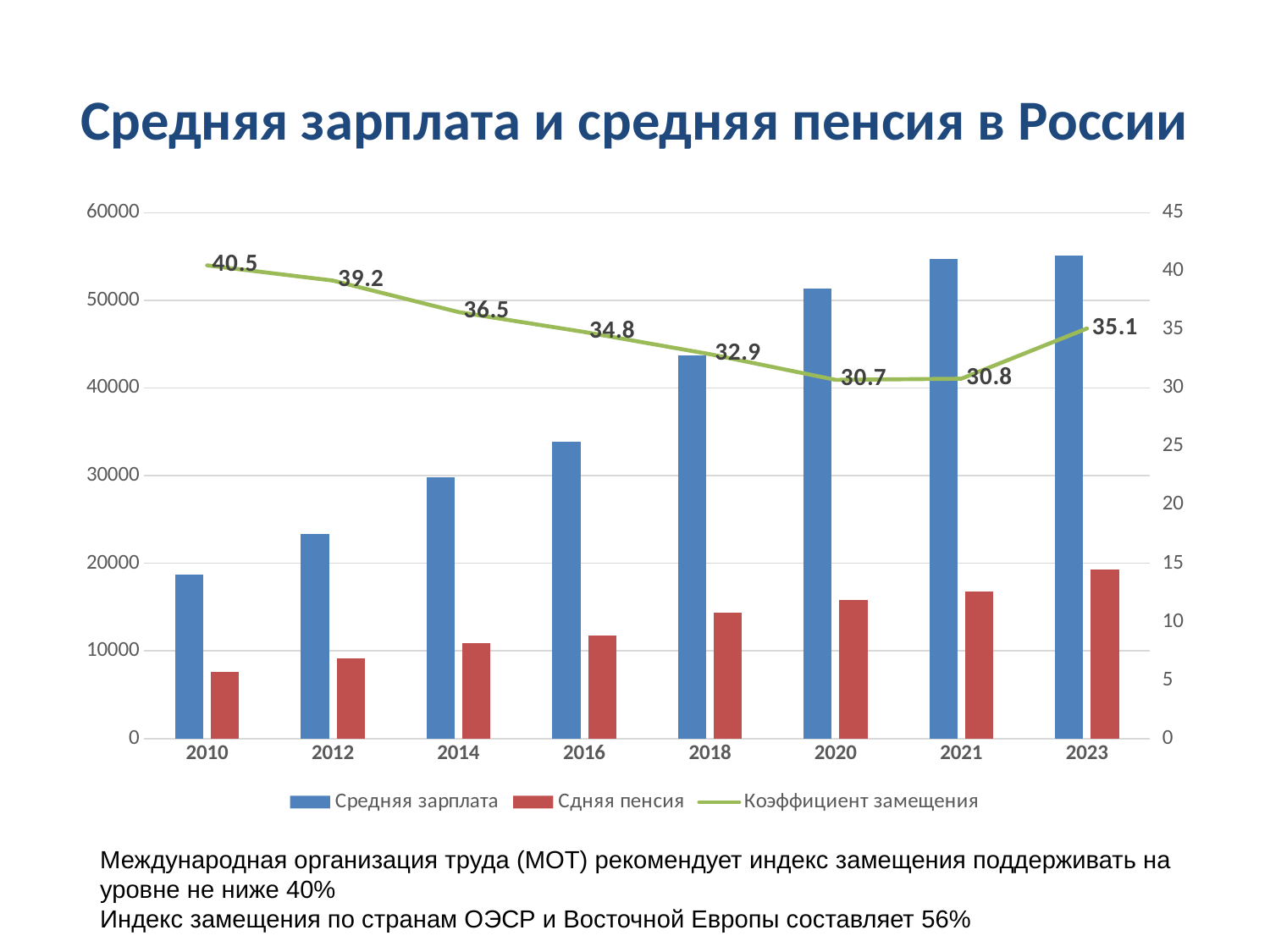
Is the replacement coefficient higher in 2018 or in 2023? 2023 In which year is the replacement coefficient (Коэффициент замещения) the highest? 2010 How many years are shown on the x axis? 8 Does the average salary (Средняя зарплата) rise or fall from 2010 to 2023? rise What is the value of the replacement coefficient (Коэффициент замещения) in 2010? 40.5 How many series does the legend list? 3 What is the value of the replacement coefficient (Коэффициент замещения) in 2023? 35.1 Is the average pension (Сдняя пенсия) in 2010 greater or less than 10000? less Is the average salary (Средняя зарплата) in 2023 greater or less than 50000? greater What is the difference between the replacement coefficient in 2010 and in 2020? 9.8 In which year is the replacement coefficient (Коэффициент замещения) the lowest? 2020 What is the value of the replacement coefficient (Коэффициент замещения) in 2020? 30.7